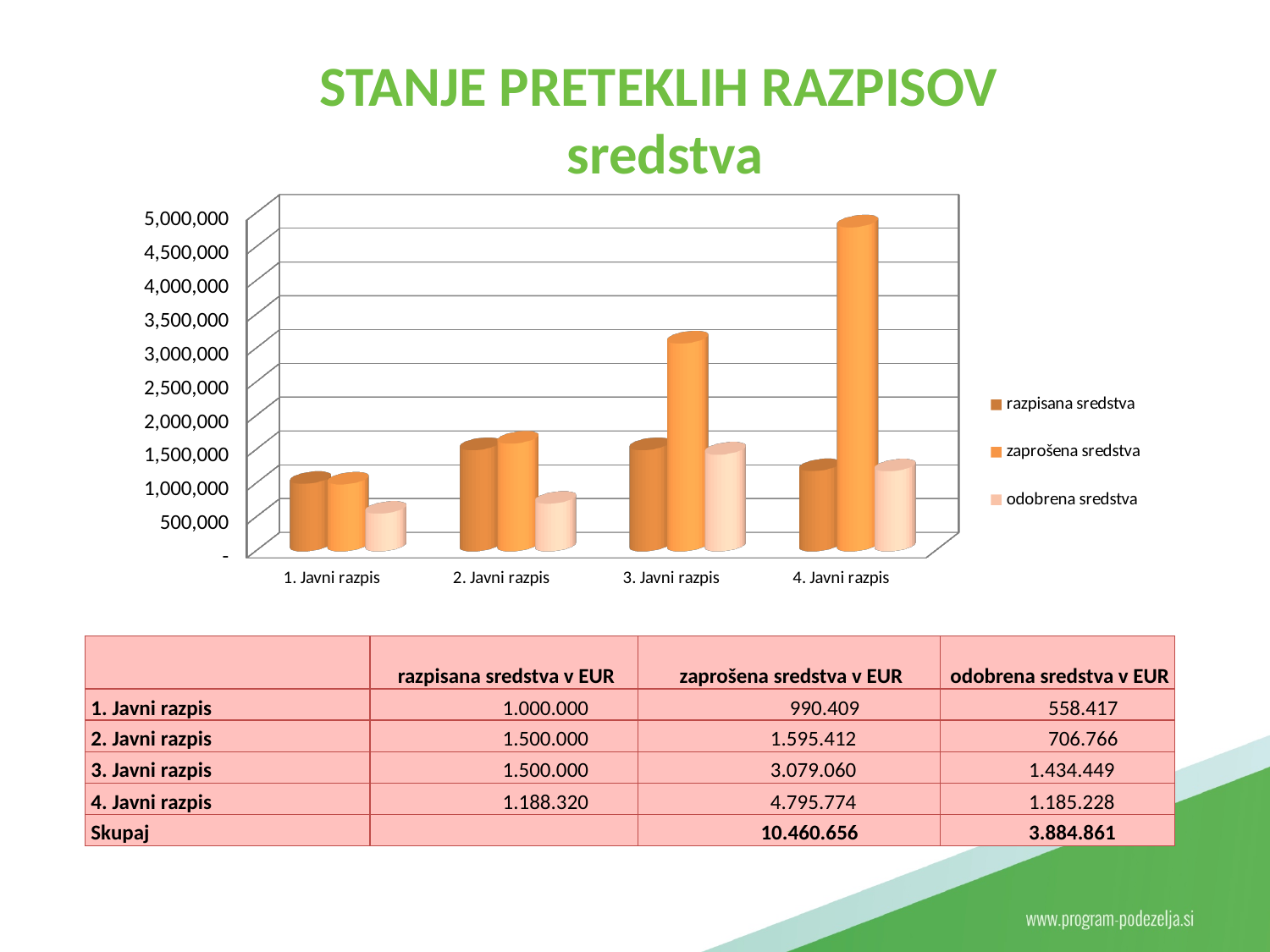
Is the zaprošena sredstva bar for 3. Javni razpis greater or less than 2,500,000? greater How many categories (javni razpisi) are shown on the x axis of the chart? 4 Which javni razpis has the lowest odobrena sredstva? 1. Javni razpis How many series does the chart legend list? 3 According to the table, what is the value of zaprošena sredstva for 4. Javni razpis? 4.795.774 Which javni razpis has the highest zaprošena sredstva? 4. Javni razpis Is the odobrena sredstva bar for 2. Javni razpis greater or less than 1,000,000? less What is the difference between zaprošena sredstva and odobrena sredstva for 3. Javni razpis, using the table values? 1.644.611 What kind of chart is shown on the slide? bar chart What is the title of the chart on the slide? STANJE PRETEKLIH RAZPISOV sredstva According to the table, what is the value of odobrena sredstva for 1. Javni razpis? 558.417 Which is larger for 2. Javni razpis: razpisana sredstva or zaprošena sredstva? zaprošena sredstva